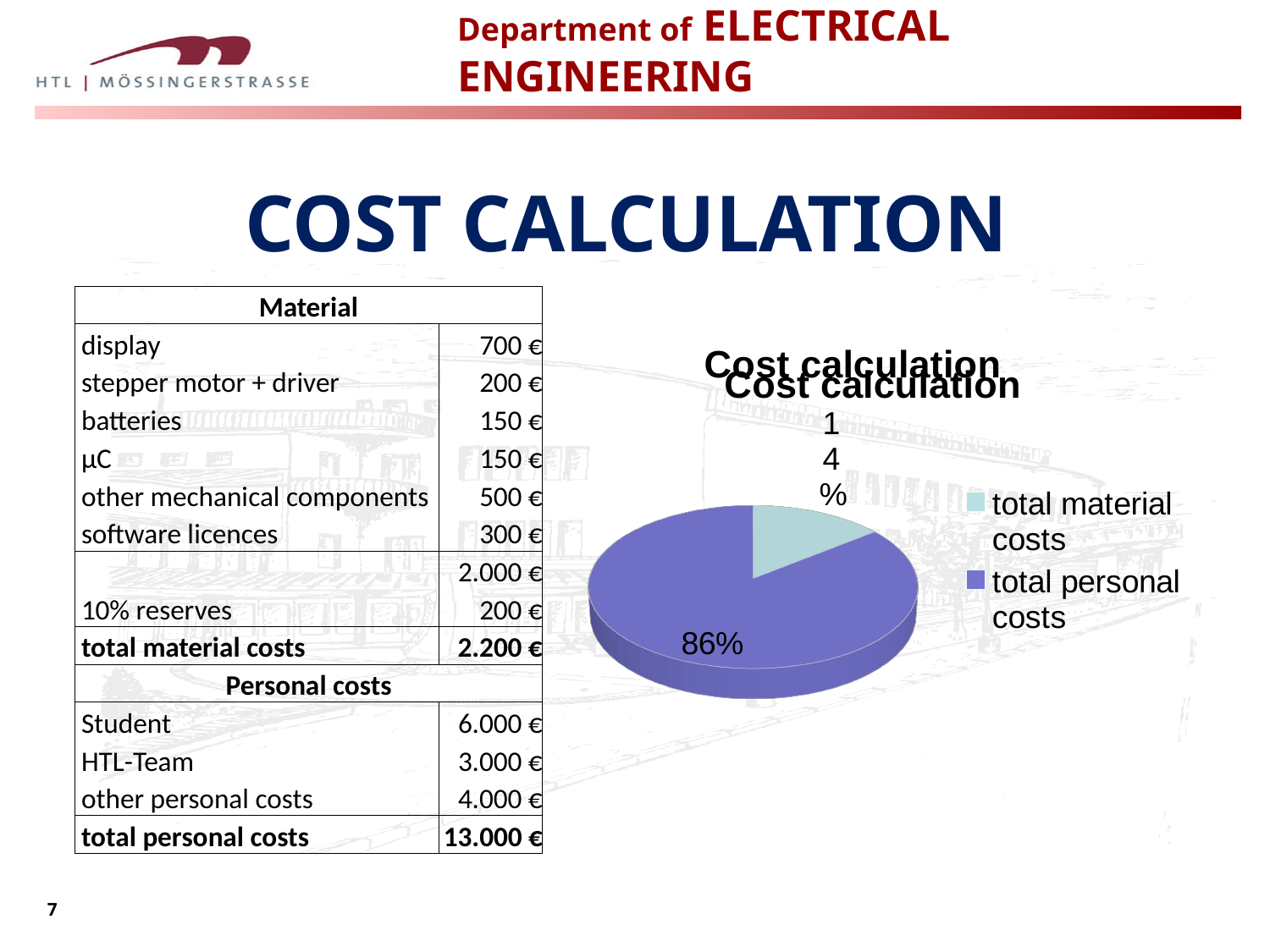
What share of the pie does total material costs take? 14% What is the title of the pie chart? Cost calculation Which is larger in the pie chart, total material costs or total personal costs? total personal costs Which category has the largest slice in the pie chart? total personal costs How many slices does the pie chart have? 2 Which category has the smallest slice in the pie chart? total material costs What kind of chart is shown on the slide? pie chart What is the difference in percentage points between the total personal costs slice and the total material costs slice? 72 Which colour represents total personal costs in the pie chart? purple What share of the pie does total personal costs take? 86% How many entries does the legend of the pie chart list? 2